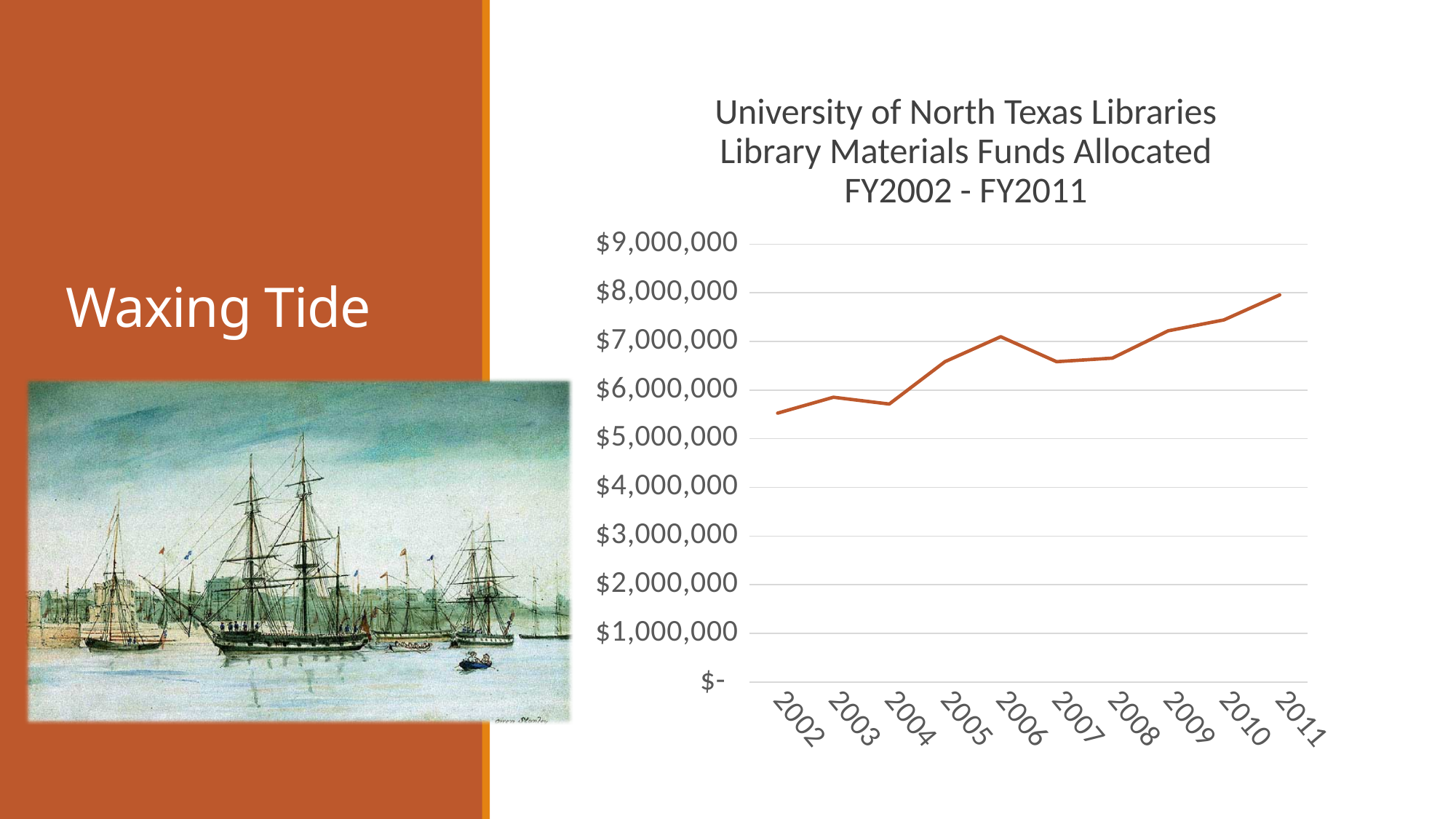
What range of fiscal years does the chart title say it covers? FY2002 - FY2011 Is the value for 2004 greater or less than $6,000,000? less Which year has the lowest library materials funds allocated? 2002 Which year has the larger value, 2006 or 2007? 2006 Which year has the larger value, 2003 or 2005? 2005 What kind of chart is shown on the slide? line chart Overall, do the funds allocated rise or fall from 2002 to 2011? rise Is the value for 2002 greater or less than $6,000,000? less How many fiscal years are plotted on the x axis of the chart? 10 Which year has the highest library materials funds allocated? 2011 Is the value for 2007 greater or less than $7,000,000? less